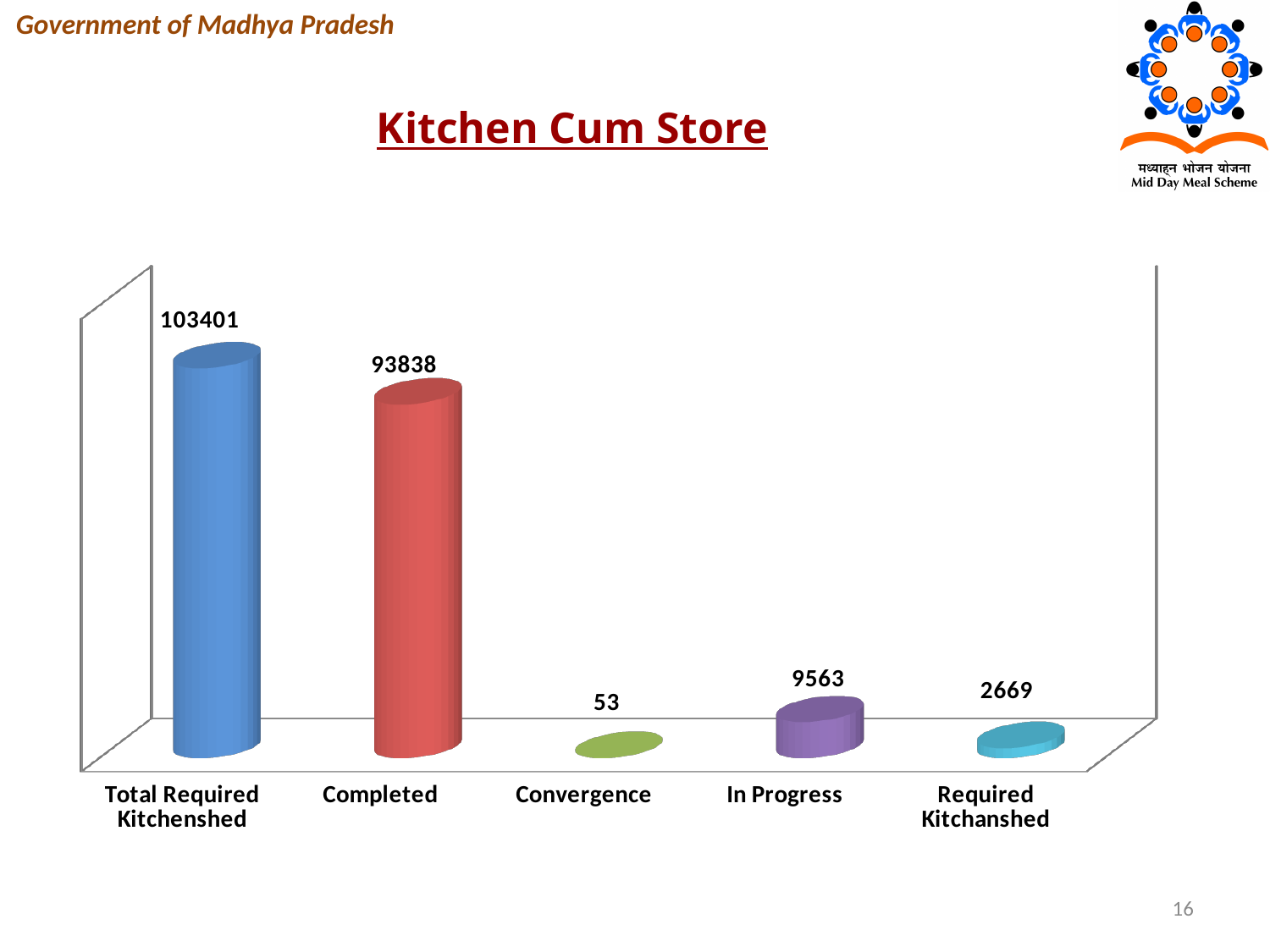
Which category has the highest value? Total Required Kitchenshed What is the value for Required Kitchanshed? 2669 What is the value for In Progress? 9563 What is the title of the chart? Kitchen Cum Store What is the value for Completed? 93838 What is the difference between Total Required Kitchenshed and Completed? 9563 Which is larger, In Progress or Required Kitchanshed? In Progress What is the value for Total Required Kitchenshed? 103401 Which category has the lowest value? Convergence How many categories are shown in the chart? 5 What is the value for Convergence? 53 What kind of chart is shown on the slide? Bar chart